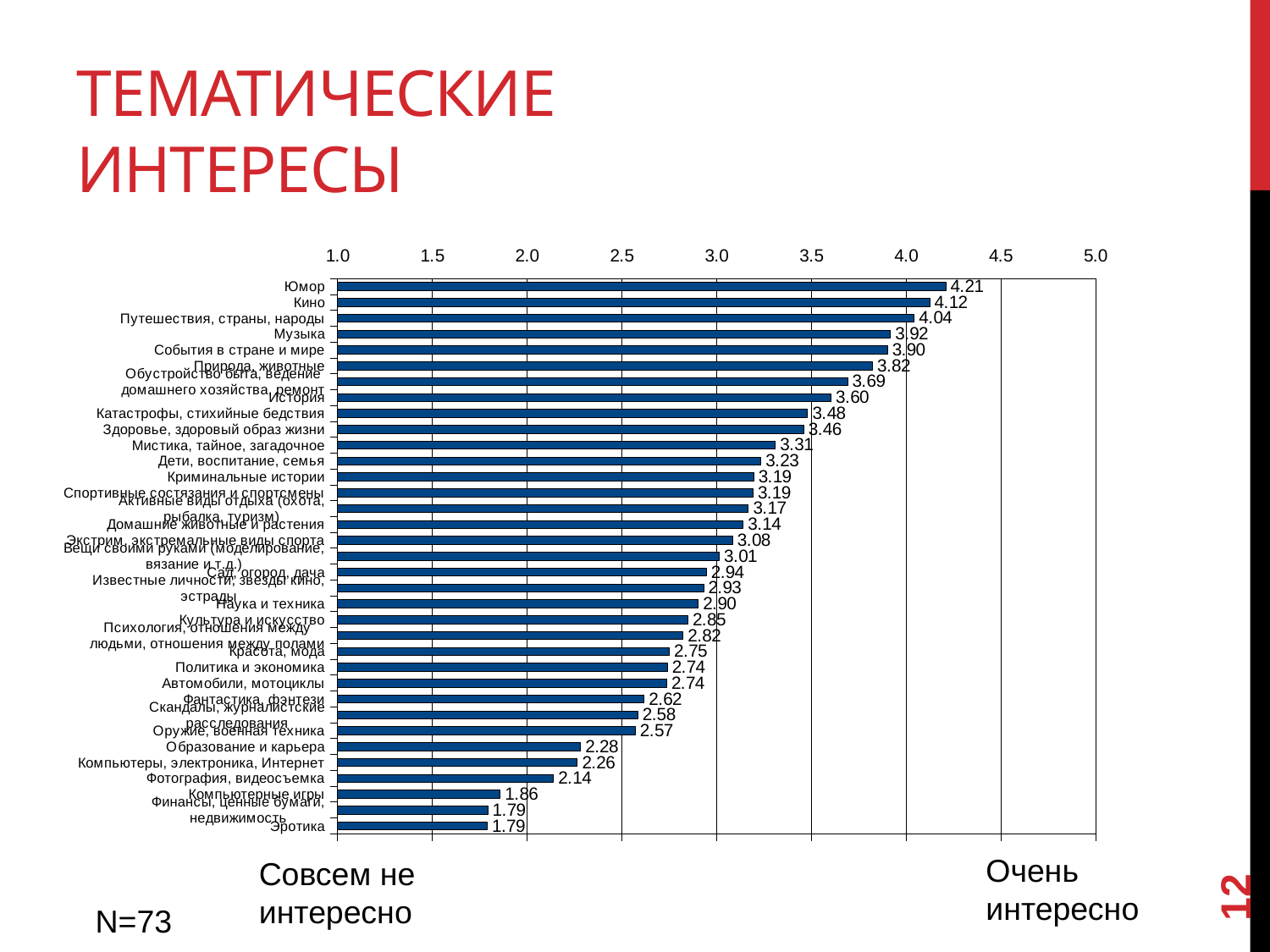
Is the value for Мистика, тайное, загадочное greater or less than 3.0? greater What is the value for Юмор? 4.21 Which category has the highest value? Юмор What is the value for Образование и карьера? 2.28 What is the value for Музыка? 3.92 What is the value for Катастрофы, стихийные бедствия? 3.48 What is the title of the slide? ТЕМАТИЧЕСКИЕ ИНТЕРЕСЫ What is the value for Кино? 4.12 What kind of chart is shown on the slide? bar chart What is the difference between the values for Юмор and Кино? 0.09 Which has a larger value, Кино or Музыка? Кино Do the values increase or decrease going from the top bar to the bottom bar? decrease